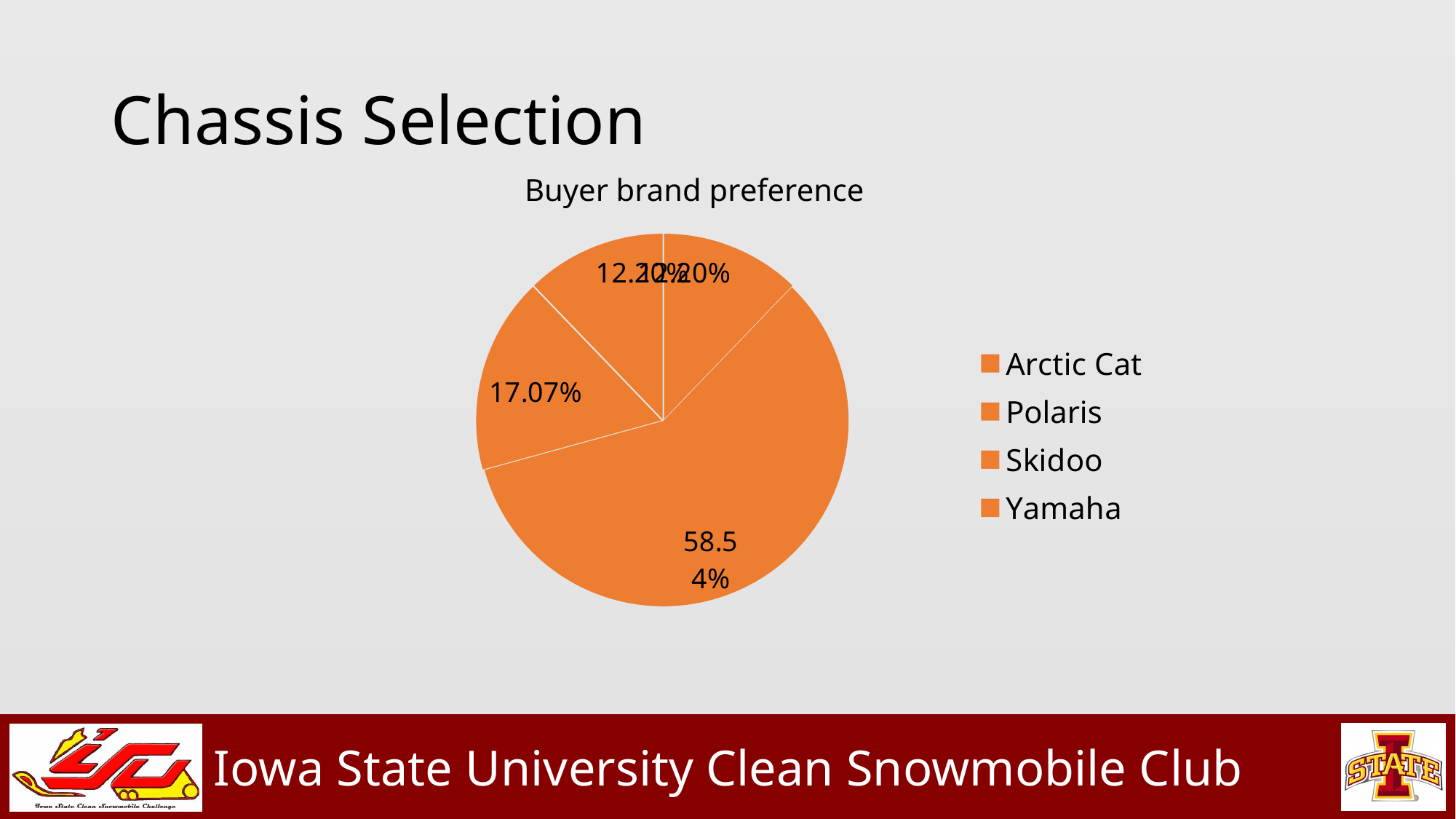
What kind of chart is shown on the slide? pie chart How many entries does the chart's legend list? 4 Which brands are listed in the chart's legend? Arctic Cat, Polaris, Skidoo, Yamaha What is the difference between the largest slice (58.54%) and the 17.07% slice? 41.47% What is the percentage shown on the largest slice of the pie? 58.54% Which is larger, the 58.54% slice or the 17.07% slice? the 58.54% slice Does the largest slice account for more or less than half of the pie? more What is the title of the chart? Buyer brand preference What is the percentage shown on the second-largest slice of the pie? 17.07% How many slices does the pie chart have? 4